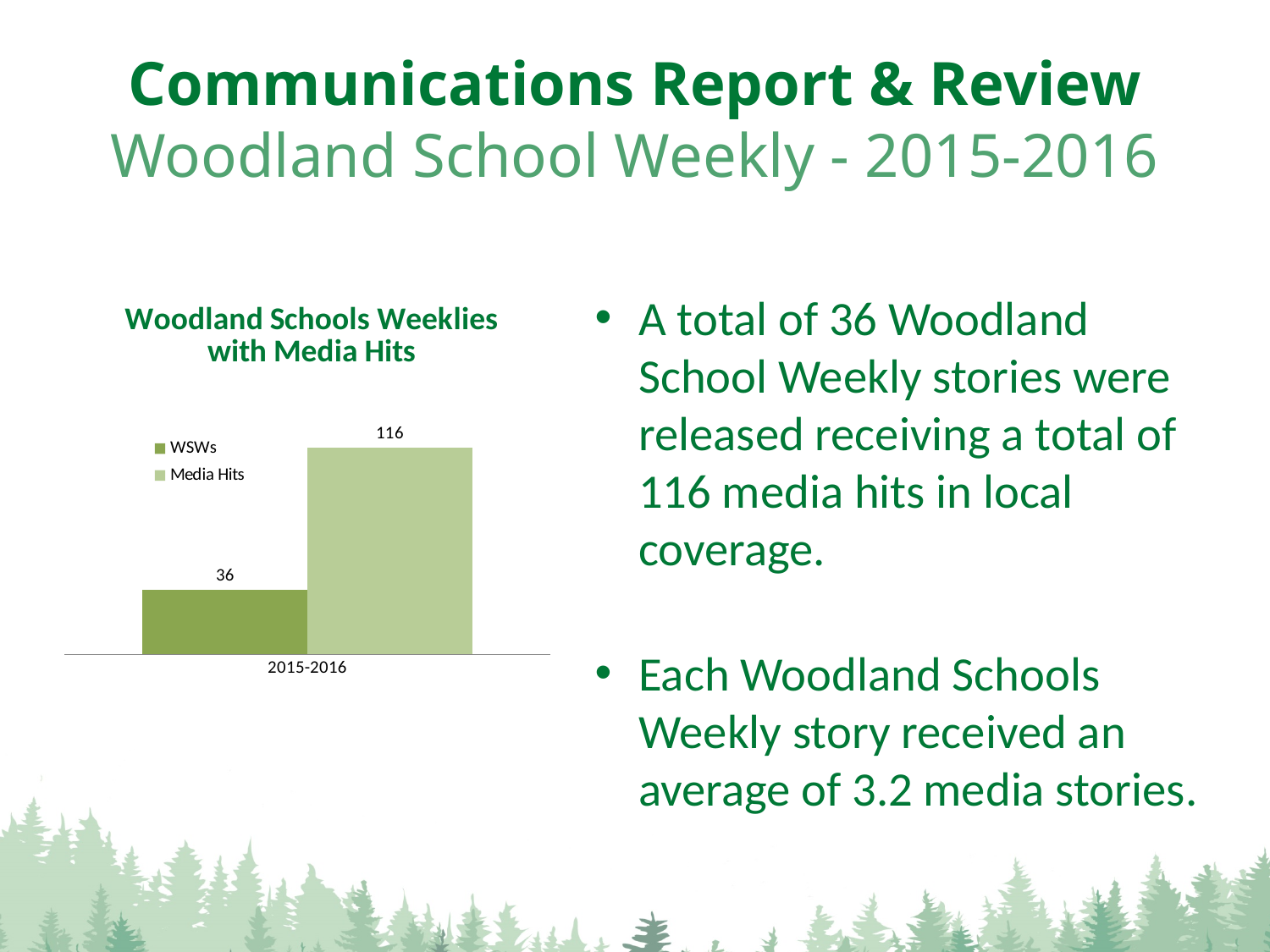
What is the difference between the Media Hits value and the WSWs value for 2015-2016? 80 Which series has the higher value in 2015-2016, WSWs or Media Hits? Media Hits Which series has the highest value in the chart? Media Hits What kind of chart is shown on the slide? Bar chart Which series has the lowest value in the chart? WSWs Which category label appears on the x axis of the chart? 2015-2016 What is the value for WSWs in 2015-2016? 36 How many categories are shown on the x axis? 1 How many series does the legend list? 2 What is the title of the chart? Woodland Schools Weeklies with Media Hits What is the value for Media Hits in 2015-2016? 116